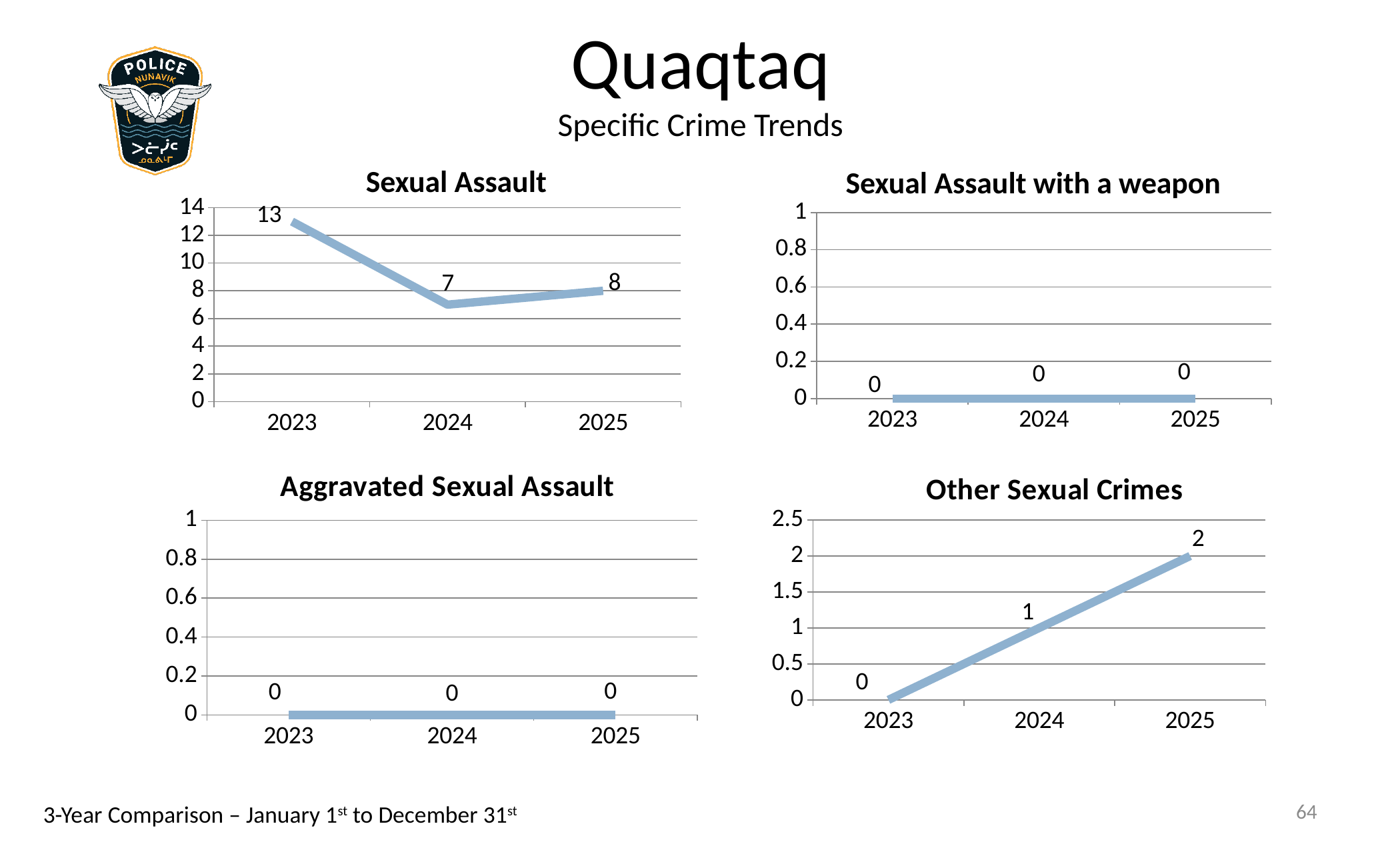
In the Sexual Assault chart, what is the value for 2024? 7 In the Sexual Assault chart, what is the difference between the 2023 and 2025 values? 5 In the Other Sexual Crimes chart, which is larger, the value for 2024 or the value for 2025? 2025 In the Other Sexual Crimes chart, do the values rise or fall from 2023 to 2025? rise In the Sexual Assault chart, which year has the lowest value? 2024 In the Sexual Assault chart, what is the value for 2023? 13 In the Sexual Assault chart, which year has the highest value? 2023 In the Other Sexual Crimes chart, what is the value for 2025? 2 In the Sexual Assault chart, is the value for 2023 greater or less than 10? greater What kind of chart is the Sexual Assault chart? line chart In the Sexual Assault with a weapon chart, what is the value for 2024? 0 How many data points are plotted in the Aggravated Sexual Assault chart? 3